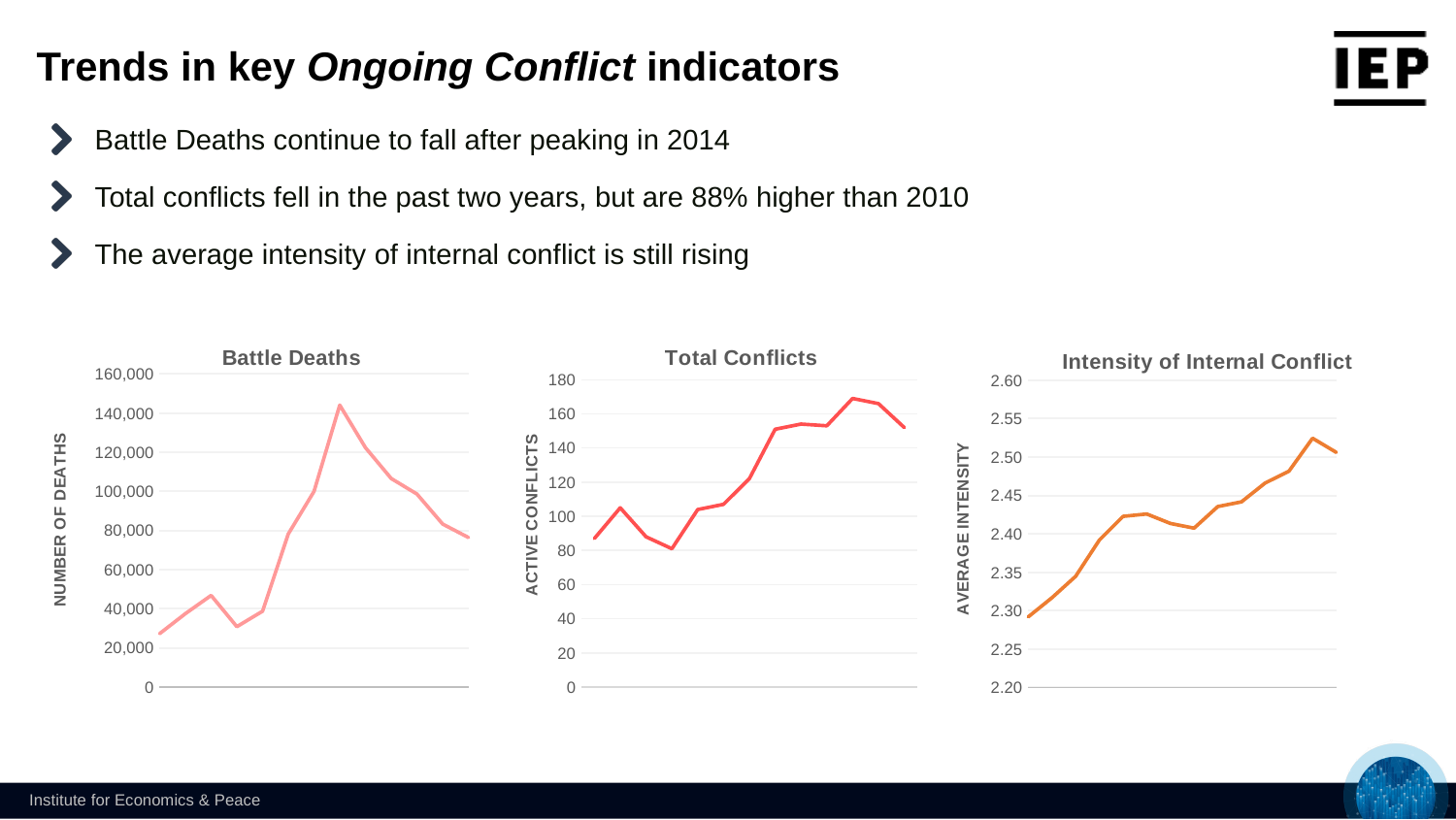
What is the y-axis title of the Total Conflicts chart? ACTIVE CONFLICTS In the Total Conflicts chart, is the lowest value greater or less than 100? less In the Intensity of Internal Conflict chart, is the last plotted value greater or less than 2.45? greater What kind of chart is the Battle Deaths chart? Line chart In the Battle Deaths chart, is the peak value greater or less than 120,000? greater In the Battle Deaths chart, do the values rise or fall after the peak? fall How many charts are shown on the slide? 3 In the Intensity of Internal Conflict chart, do the values generally rise or fall along the x axis? rise What is the y-axis title of the Intensity of Internal Conflict chart? AVERAGE INTENSITY